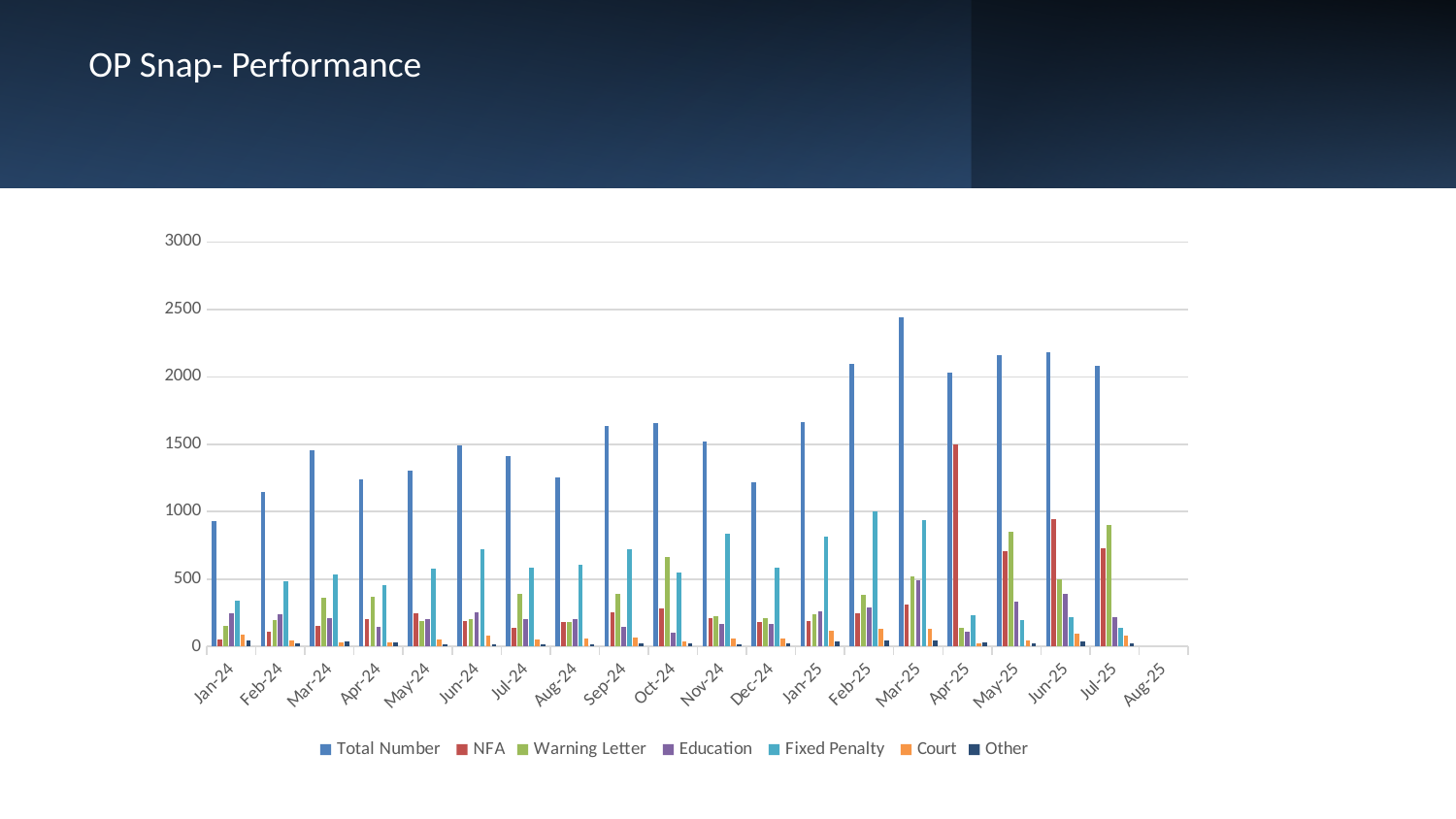
How many month categories are shown on the x axis? 20 Does the Total Number series rise or fall from Jan-24 to Mar-24? Rise What kind of chart is shown on the slide? Bar chart Which month has the highest Total Number bar? Mar-25 Is the Fixed Penalty value for Jan-24 greater or less than 500? less Is the Total Number value for Mar-25 greater or less than 2000? greater How many series does the legend list? 7 Is the Total Number value for Jan-24 greater or less than 1000? less Which is larger, the Fixed Penalty value for Mar-25 or for Apr-25? Mar-25 What is the title of the slide containing the chart? OP Snap- Performance Which is larger, the NFA value for Apr-25 or the NFA value for Jun-25? Apr-25